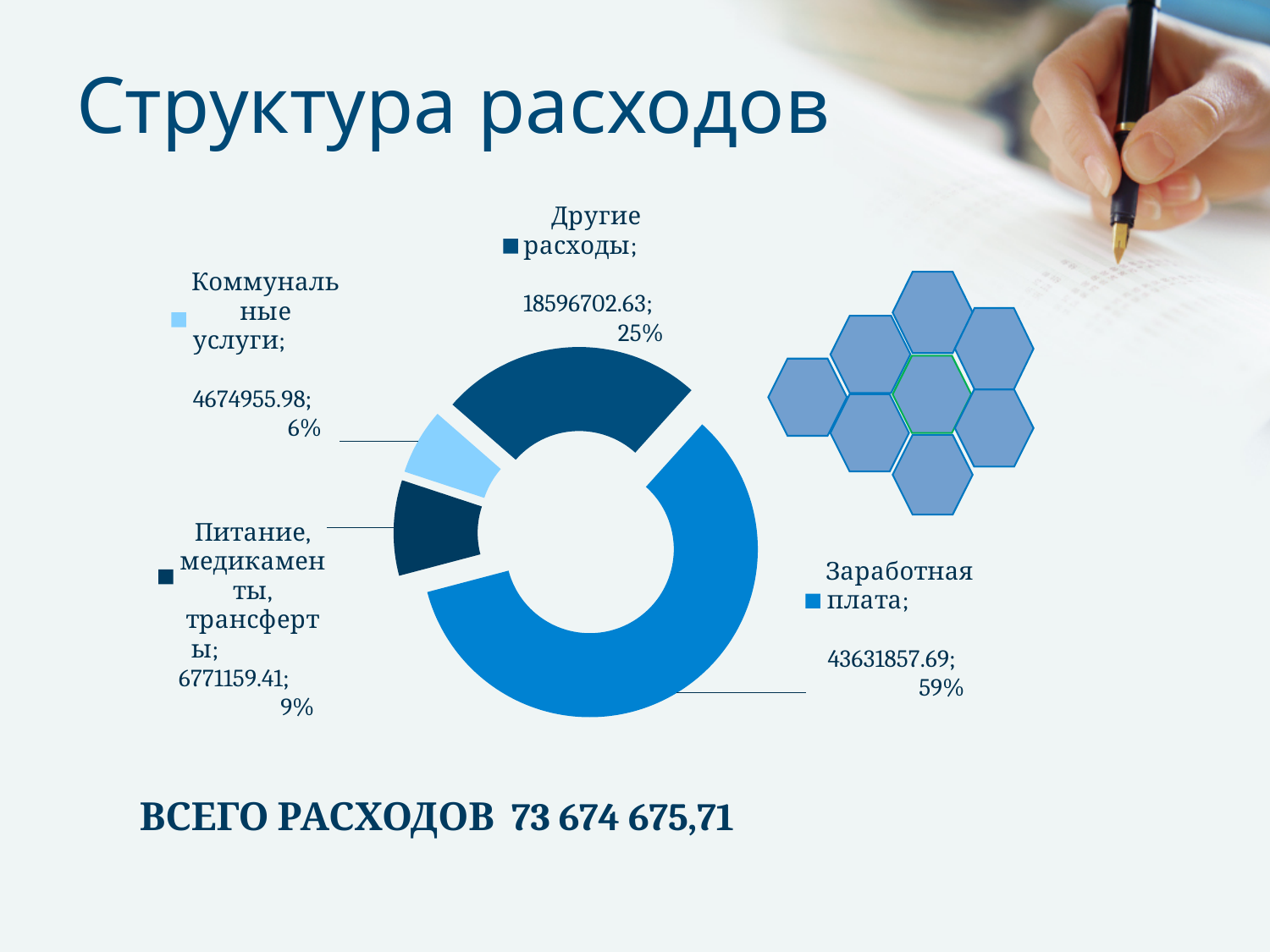
How many categories are shown in the chart? 4 Which category has the largest share of expenses? Заработная плата Which category has the smallest share of expenses? Коммунальные услуги What kind of chart is shown on the slide? Doughnut (pie) chart What percentage share does Питание, медикаменты, трансферты have? 9% What is the value for Заработная плата? 43631857.69 What is the title of the slide containing the chart? Структура расходов Which is larger: Другие расходы or Питание, медикаменты, трансферты? Другие расходы What total expenses figure is stated below the chart? 73 674 675,71 What is the value for Коммунальные услуги? 4674955.98 What percentage share does Другие расходы have? 25% What is the difference in percentage points between Заработная плата and Другие расходы? 34 percentage points